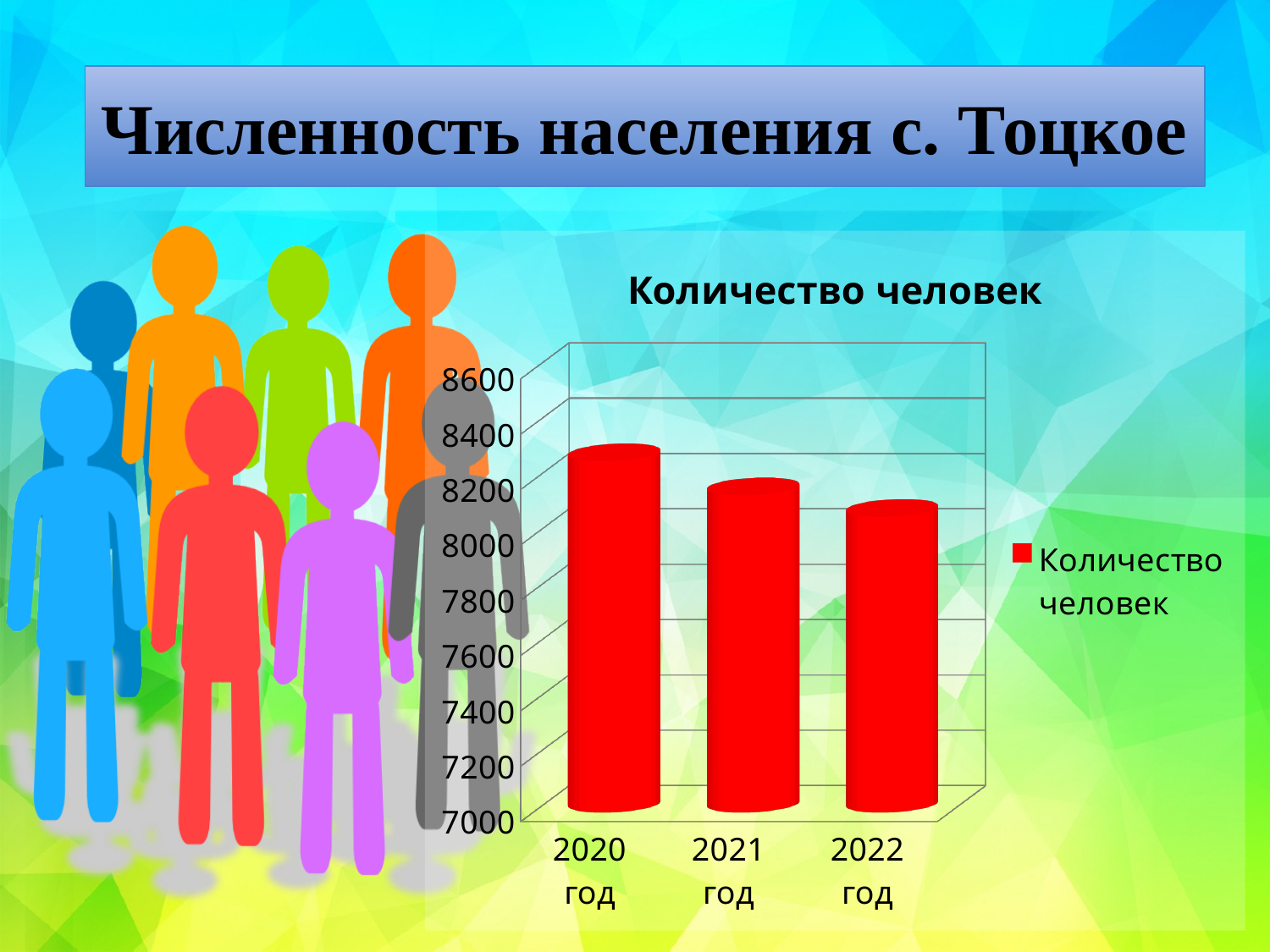
Do the values rise or fall from 2020 to 2022? fall Which is larger, the value for 2020 год or the value for 2022 год? 2020 год What kind of chart is shown on the slide? bar chart What is the title of the chart? Количество человек Is the value for 2020 год greater or less than 8200? greater Which year has the highest value on the chart? 2020 год Is the value for 2022 год greater or less than 8200? less How many series does the legend list? 1 What colour are the bars on the chart? red Is the value for 2021 год greater or less than 8000? greater How many categories (years) are plotted on the chart? 3 Which year has the lowest value on the chart? 2022 год